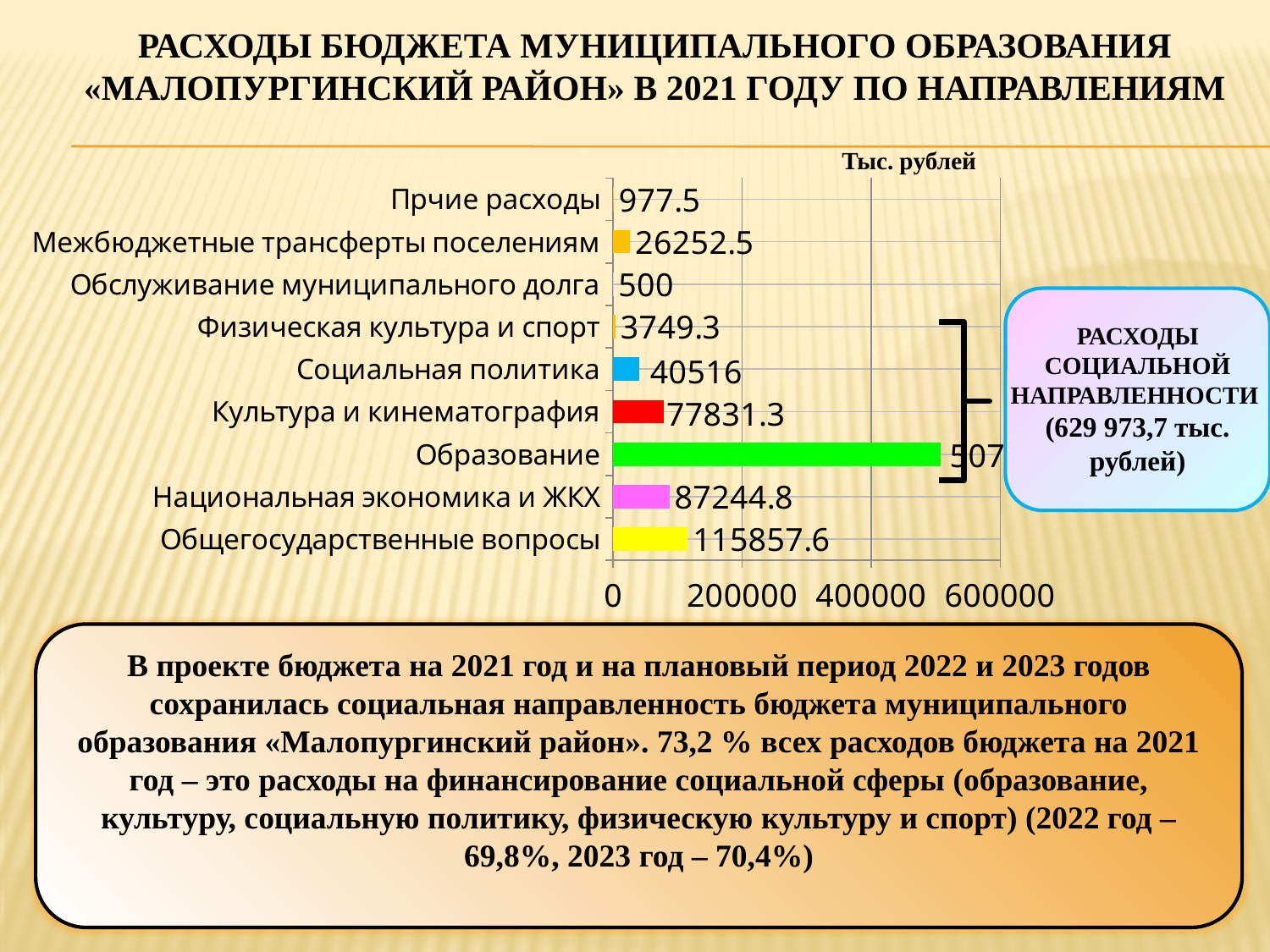
What is the value for Общегосударственные вопросы? 115857.6 Which category has the highest value in the chart? Образование Which is larger: the value for Социальная политика or the value for Культура и кинематография? Культура и кинематография What kind of chart is shown on the slide? bar chart What unit is stated above the chart? Тыс. рублей Which category has the lowest value in the chart? Обслуживание муниципального долга What is the value for Культура и кинематография? 77831.3 How many categories are plotted in the chart? 9 What is the value for Национальная экономика и ЖКХ? 87244.8 What is the value for Межбюджетные трансферты поселениям? 26252.5 What is the difference between the values for Общегосударственные вопросы and Национальная экономика и ЖКХ? 28612.8 Is the value for Образование greater or less than 400000? greater